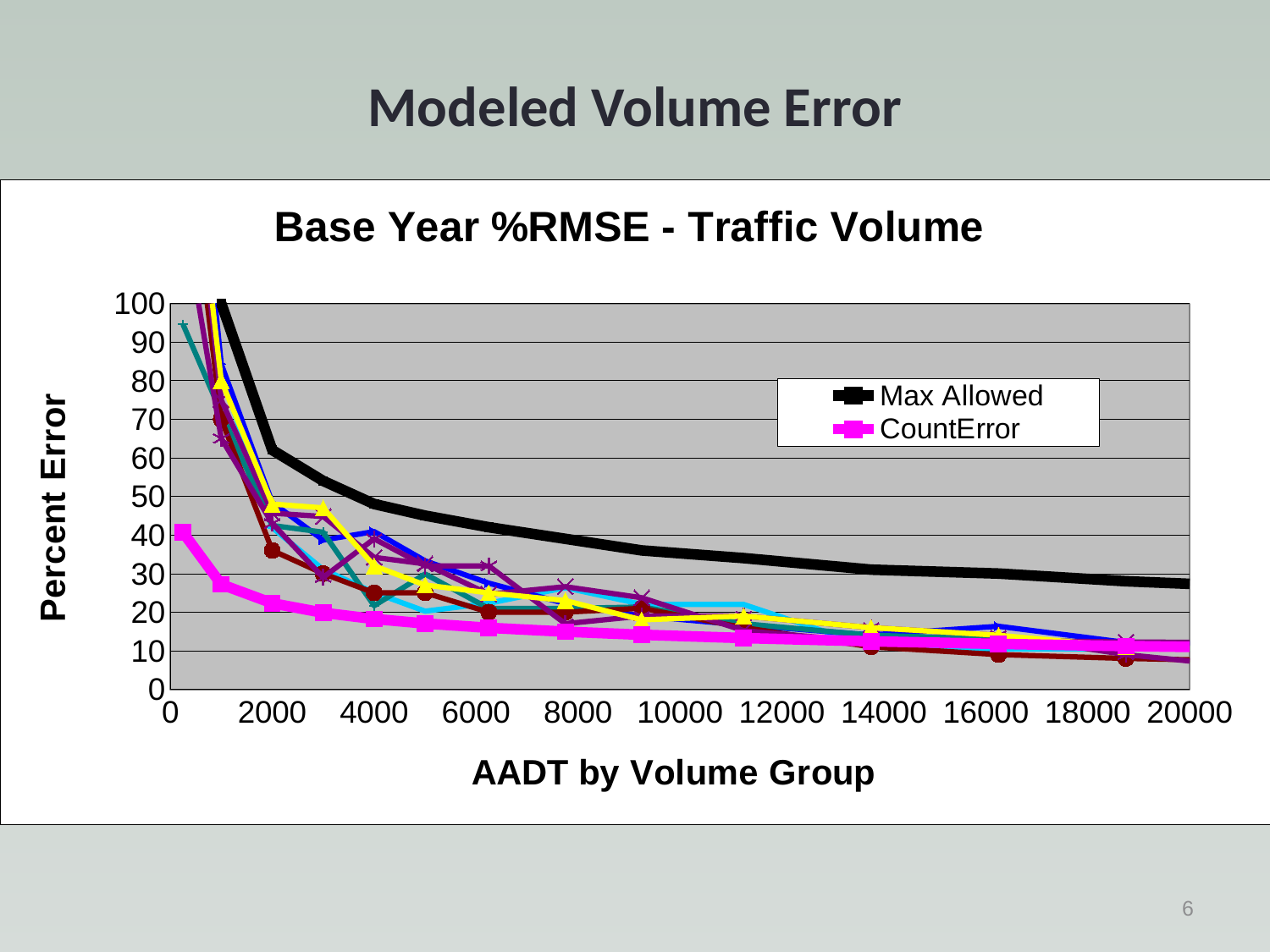
Is the value of Max Allowed at an AADT of 10000 greater or less than 40? less Is the value of Max Allowed at an AADT of 10000 greater or less than 30? greater What is the label of the vertical axis? Percent Error Does the CountError series rise or fall as AADT increases? fall Is the value of CountError at an AADT of 20000 greater or less than 20? less Does the Max Allowed series rise or fall as AADT increases? fall What is the highest value shown on the Percent Error axis? 100 What kind of chart is shown on the slide? line chart What is the title of the chart? Base Year %RMSE - Traffic Volume At an AADT of 10000, which series has the larger value, Max Allowed or CountError? Max Allowed How many series does the legend list? 2